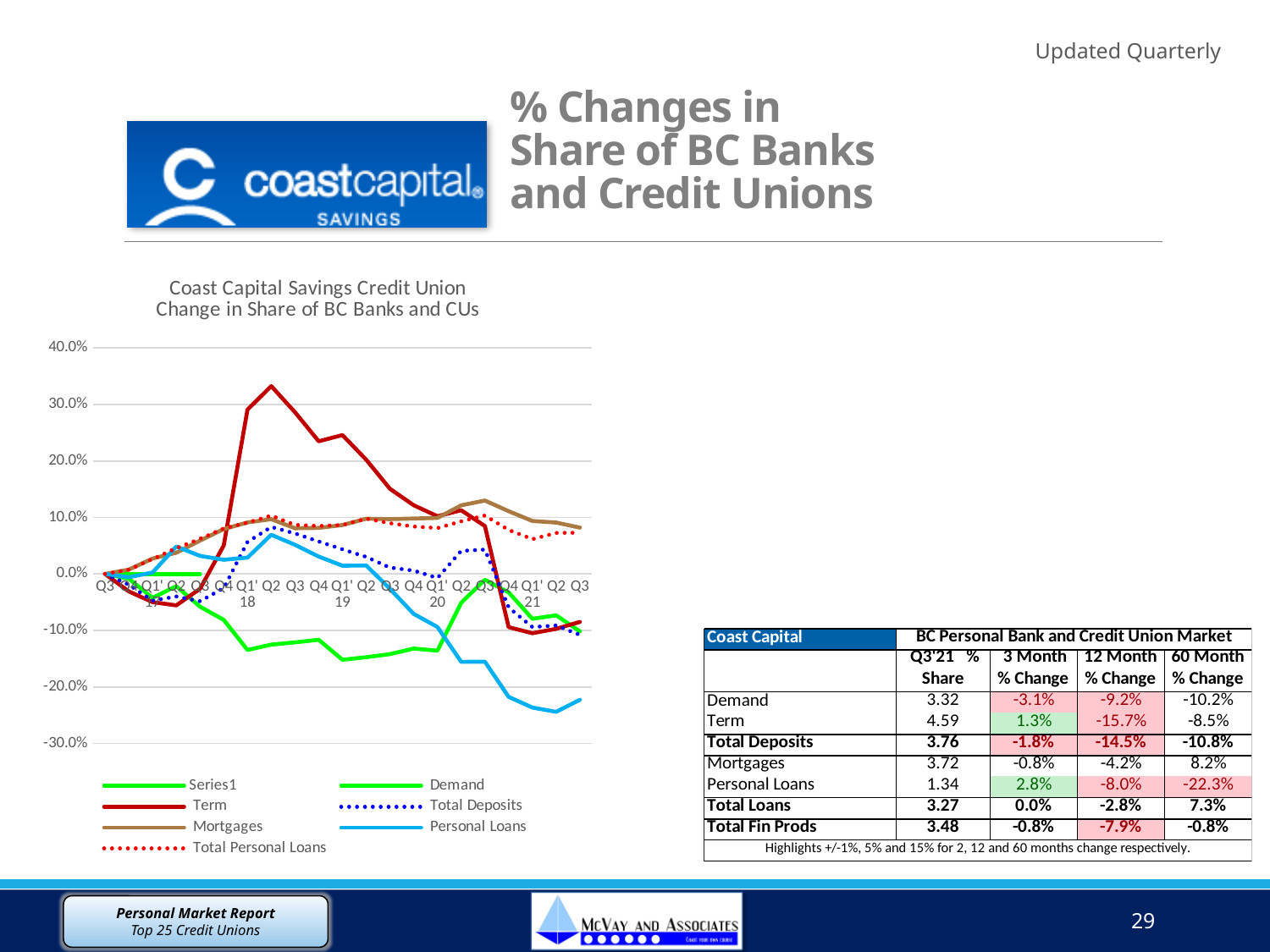
Is the value for Personal Loans at Q3 21 greater or less than -20.0%? less Does the Personal Loans series rise or fall from Q1 20 to Q3 21? fall Is the value for Demand at Q1 19 greater or less than -10.0%? less Which legend entry is drawn as a dotted blue line? Total Deposits What kind of chart is shown on the slide? line chart Is the peak value of the Term series greater or less than 30.0%? greater Which series reaches the lowest value anywhere on the chart? Personal Loans What is the title of the chart? Coast Capital Savings Credit Union Change in Share of BC Banks and CUs How many series does the chart legend list? 7 Which series reaches the highest value anywhere on the chart? Term At Q3 21, which series is higher: Mortgages or Personal Loans? Mortgages